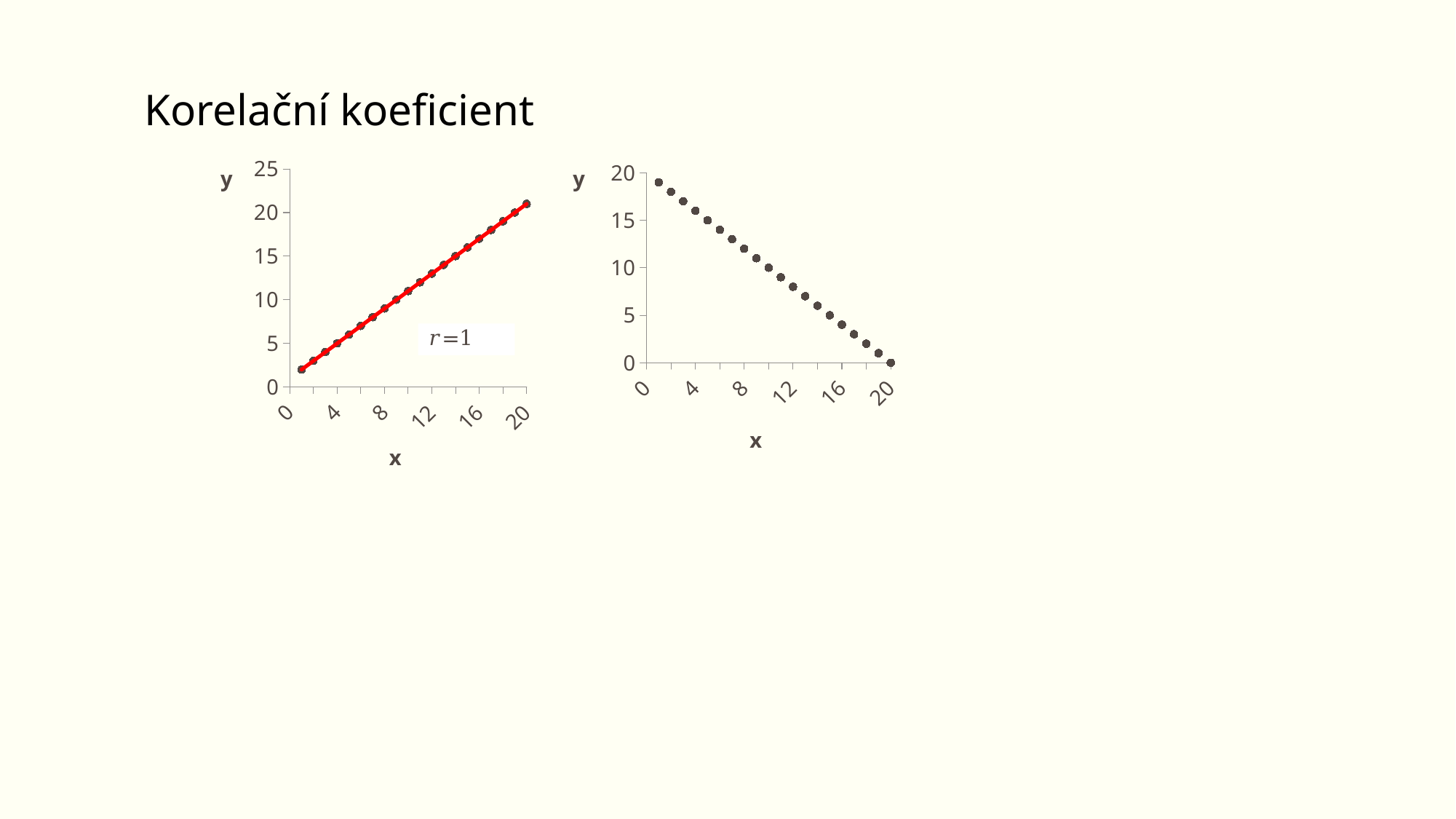
In the right chart, what is the y value of the point at x = 20? 0 In the left chart, is the y value at x = 20 greater or less than 15? greater In the left chart, what correlation coefficient is shown in the text box? r = 1 In the left chart, which point has the larger y value, the one at x = 4 or the one at x = 16? x = 16 In the right chart, which point has the highest y value, the one at x = 4 or the one at x = 16? x = 4 In the right chart, is the y value at x = 16 greater or less than 5? less What kind of chart is the right chart on the slide? scatter chart In the right chart, do the y values rise or fall as x increases? fall What is the title of the slide? Korelační koeficient What kind of chart is the left chart on the slide? scatter chart In the right chart, is the y value at x = 4 greater or less than 15? greater In the left chart, do the y values rise or fall as x increases? rise